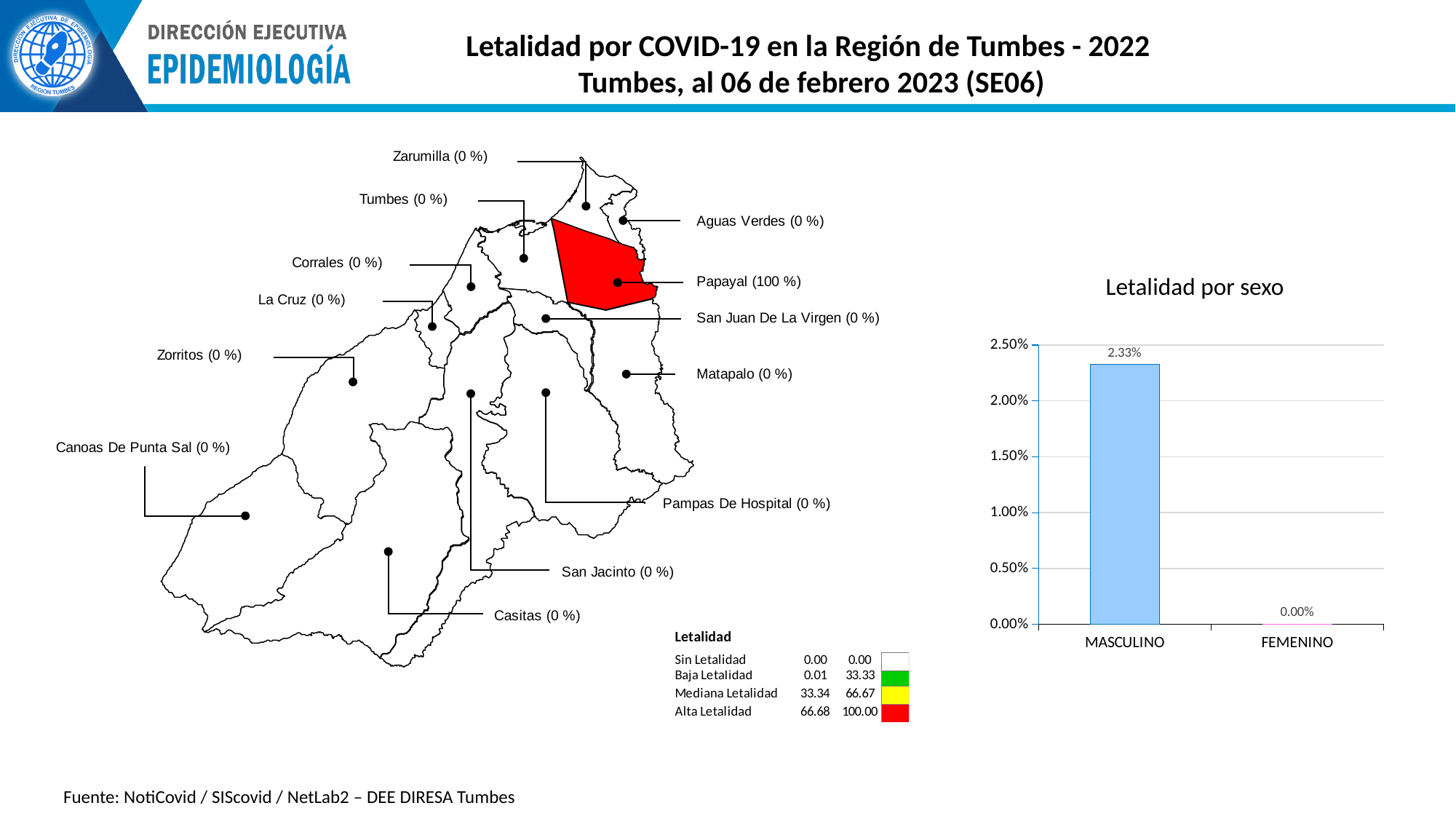
In the 'Letalidad por sexo' chart, which category has the highest value? MASCULINO In the 'Letalidad por sexo' chart, what is the difference between the MASCULINO and FEMENINO values? 2.33% What is the title of the chart on the right side of the slide? Letalidad por sexo In the 'Letalidad por sexo' chart, is the value for MASCULINO greater or less than 2.50%? less In the 'Letalidad por sexo' chart, what is the value for MASCULINO? 2.33% In the 'Letalidad por sexo' chart, is the value for MASCULINO greater or less than 2.00%? greater How many categories are shown in the 'Letalidad por sexo' chart? 2 On the map, which district is shaded red? Papayal What kind of chart is 'Letalidad por sexo'? Bar chart In the 'Letalidad por sexo' chart, what is the value for FEMENINO? 0.00% On the map, what is the letalidad value shown for Papayal? 100 % In the 'Letalidad por sexo' chart, which category has the lowest value? FEMENINO